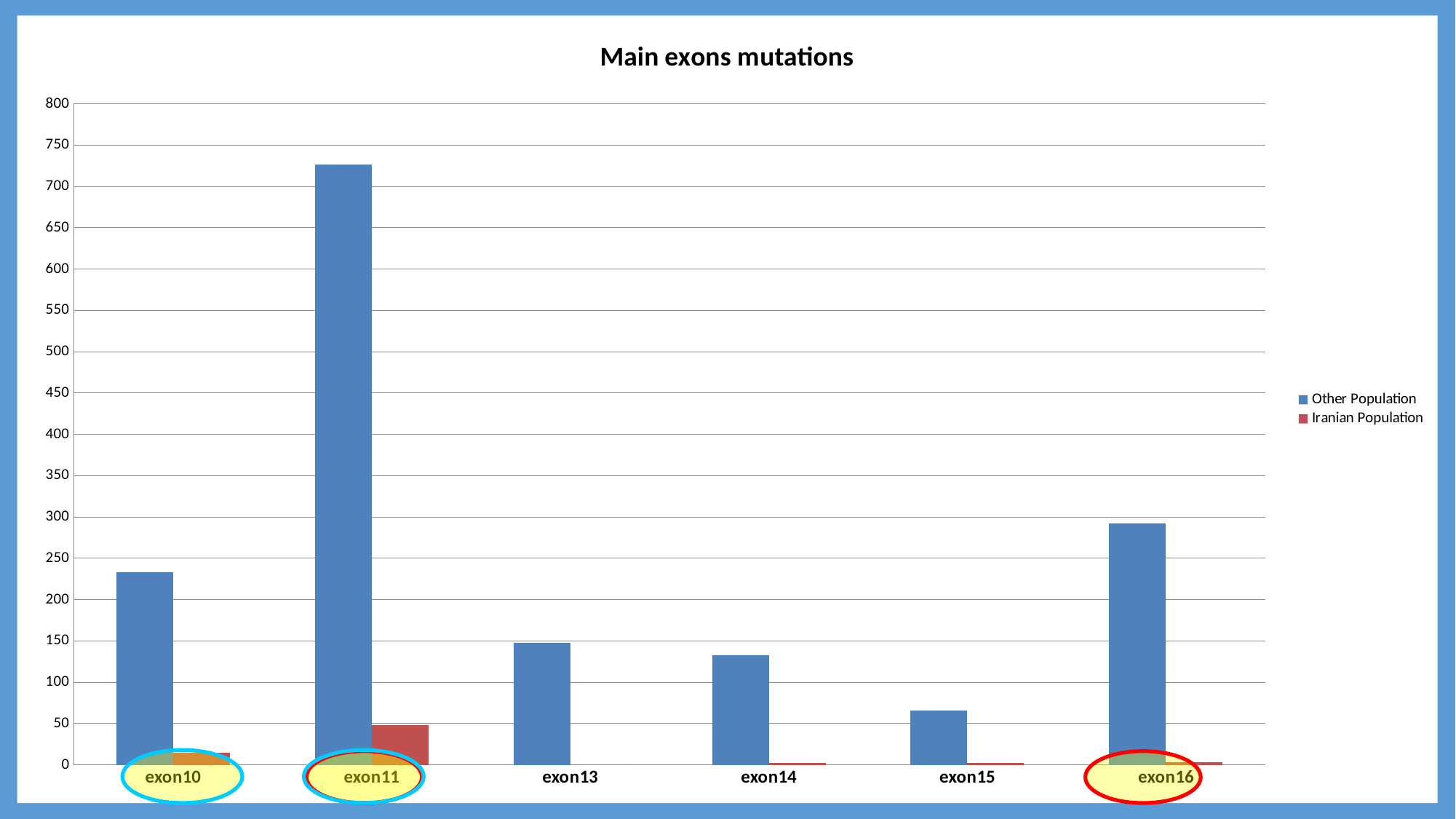
Which series is shown in blue in the legend? Other Population Which exon has the highest value for Other Population? exon11 Is the Other Population value for exon11 greater or less than 700? greater Is the Other Population value for exon10 greater or less than 200? greater Which exon has the highest value for Iranian Population? exon11 Which has the larger Other Population value, exon10 or exon16? exon16 Which exon has the lowest value for Other Population? exon15 What is the title of the chart? Main exons mutations What type of chart is shown on the slide? bar chart Is the Other Population value for exon15 greater or less than 100? less How many exon categories are shown on the x axis? 6 How many series does the legend list? 2